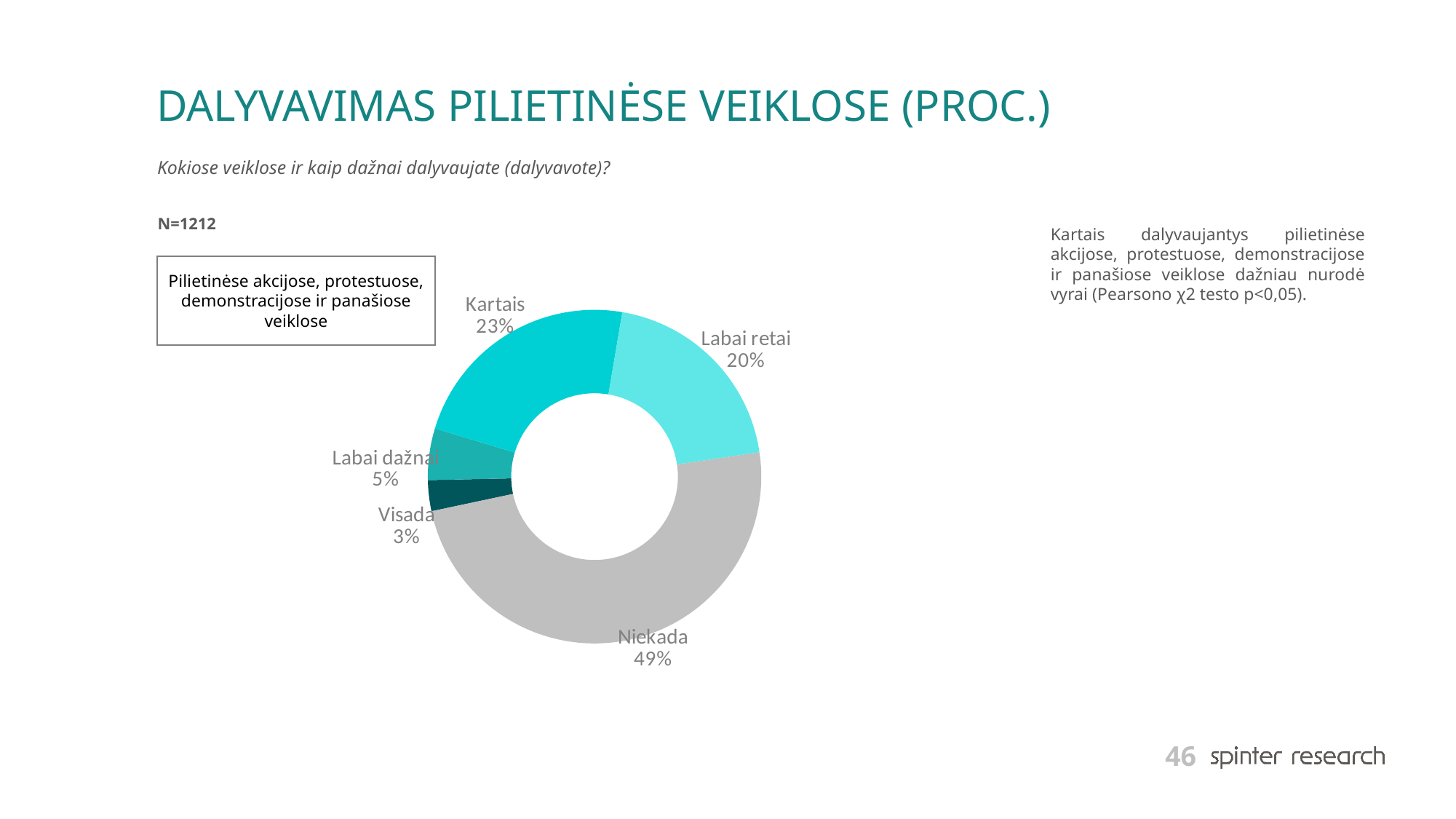
Which category has the largest share of the chart? Niekada Which category has the smallest share of the chart? Visada Which is larger, the share for "Kartais" or the share for "Labai retai"? Kartais What percentage of respondents answered "Visada"? 3% What percentage of respondents answered "Niekada"? 49% What kind of chart is shown on the slide? Doughnut chart What percentage of respondents answered "Labai retai"? 20% How many categories are shown in the chart? 5 What is the difference in percentage points between "Labai dažnai" and "Visada"? 2 What is the sample size (N) stated on the slide? N=1212 What is the difference in percentage points between "Niekada" and "Kartais"? 26 What percentage of respondents answered "Kartais"? 23%